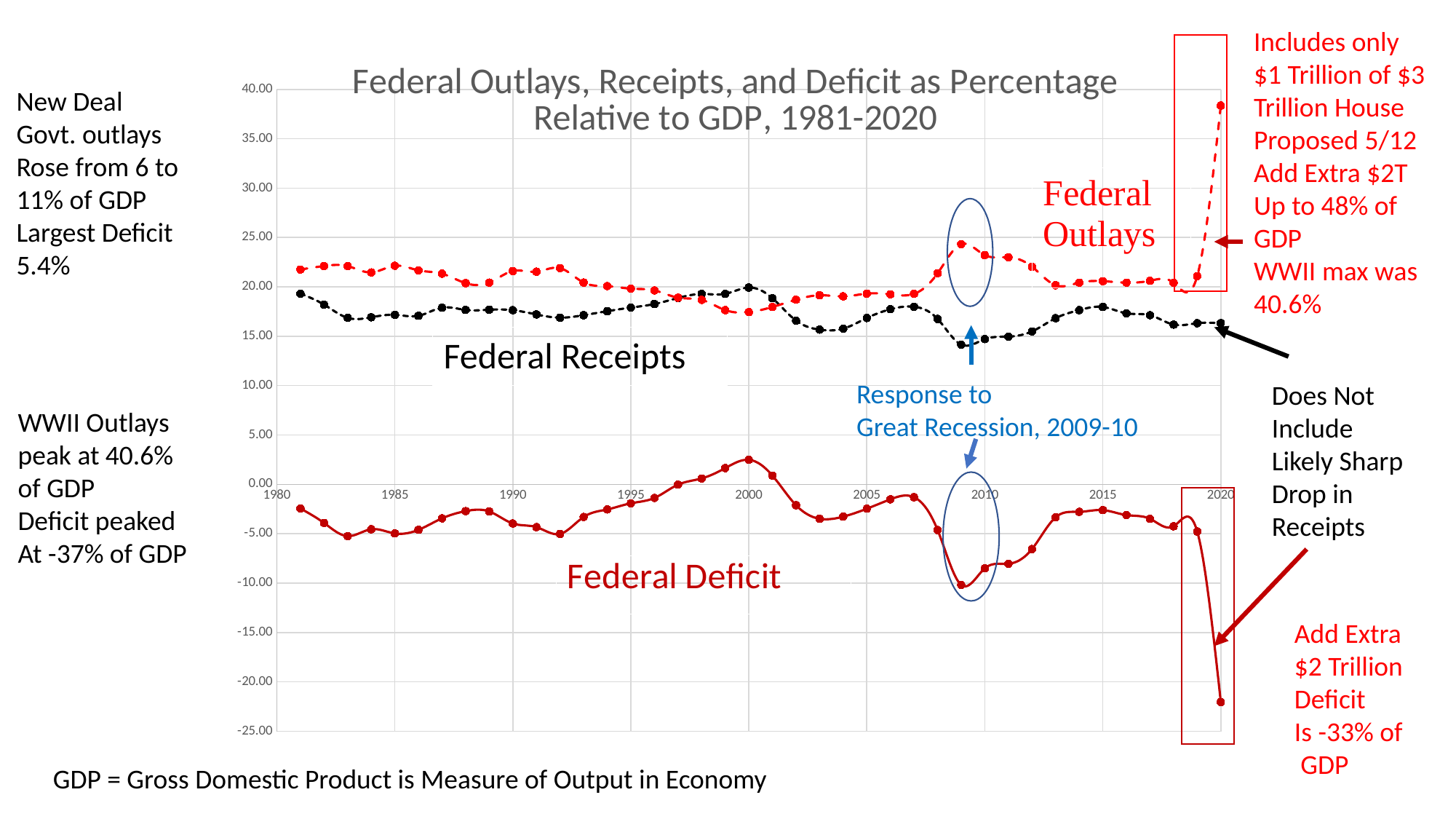
Does the Federal Deficit series rise or fall between 2009 and 2015? rise Is the value for Federal Deficit in 2020 greater or less than -20? less Is the value for Federal Receipts in 2009 greater or less than 15? less How many data series are plotted on the chart? 3 Is the value for Federal Deficit in 2000 greater or less than 0? greater What is the title of the chart? Federal Outlays, Receipts, and Deficit as Percentage Relative to GDP, 1981-2020 In 2000, which is higher, Federal Outlays or Federal Receipts? Federal Receipts In which year does the Federal Deficit series reach its lowest value? 2020 What kind of chart is shown on the slide? Line chart In which year does the Federal Outlays series reach its highest value? 2020